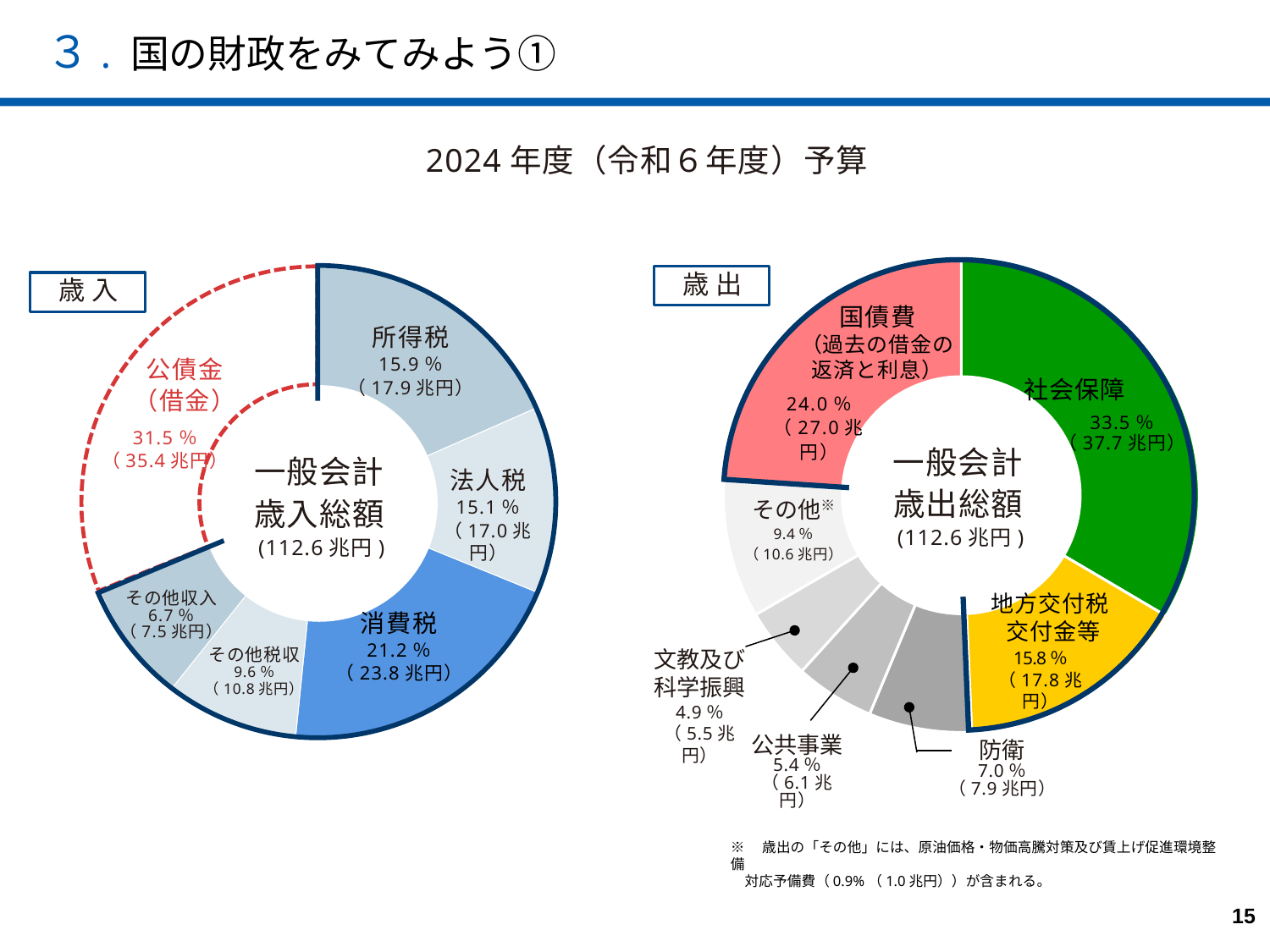
歳入のグラフで、公債金（借金）の金額はいくらですか？ 35.4兆円 歳出のグラフで、国債費の割合は何%ですか？ 24.0% 歳出のグラフで、最も割合が小さい項目はどれですか？ 文教及び科学振興 歳出のグラフには項目がいくつありますか？ 7 このスライドの2つのグラフはどのような種類のグラフですか？ ドーナツグラフ（円グラフ） 歳入のグラフで、所得税と法人税の割合の差は何ポイントですか？ 0.8ポイント 歳出のグラフで、防衛と公共事業ではどちらの割合が大きいですか？ 防衛 歳出のグラフで、社会保障の金額はいくらですか？ 37.7兆円 歳入のグラフで、最も割合が小さい項目はどれですか？ その他収入 歳入のグラフには項目がいくつありますか？ 6 歳入のグラフで、消費税の割合は何%ですか？ 21.2% 歳入のグラフで、最も割合が大きい項目はどれですか？ 公債金（借金）